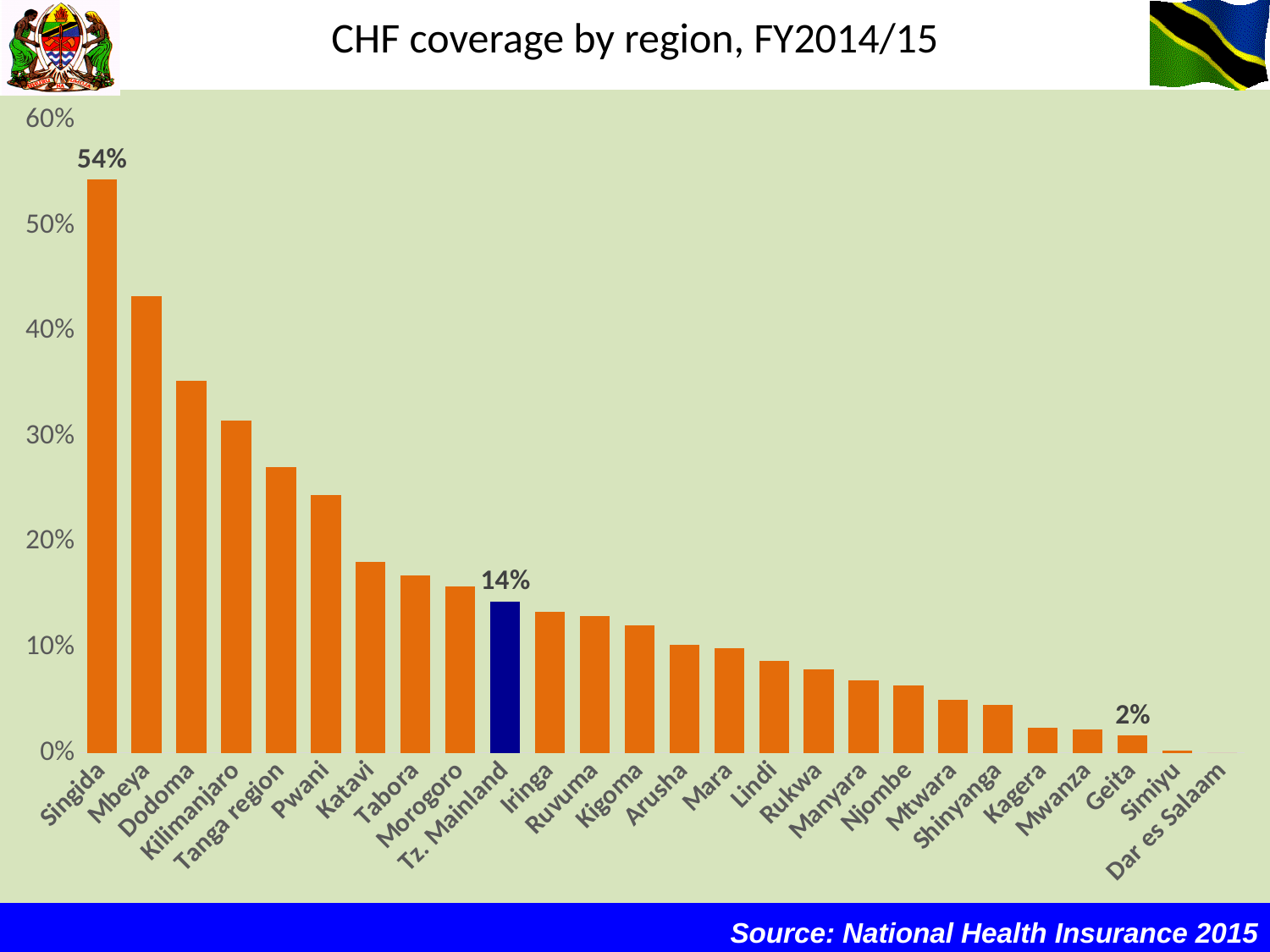
Which has higher CHF coverage, Mbeya or Dodoma? Mbeya Is the value for Lindi greater or less than 10%? less What is the CHF coverage value shown for Tz. Mainland? 14% Is the value for Mbeya greater or less than 40%? greater What is the CHF coverage value shown for Geita? 2% Is the value for Tanga region greater or less than 30%? less How many percentage points higher is Singida's coverage than Tz. Mainland's? 40 percentage points Which region has the highest CHF coverage? Singida How many regions (categories) are shown on the x axis? 26 What kind of chart is shown on the slide? Bar chart What is the CHF coverage value shown for Singida? 54% Which region has the lowest CHF coverage? Dar es Salaam